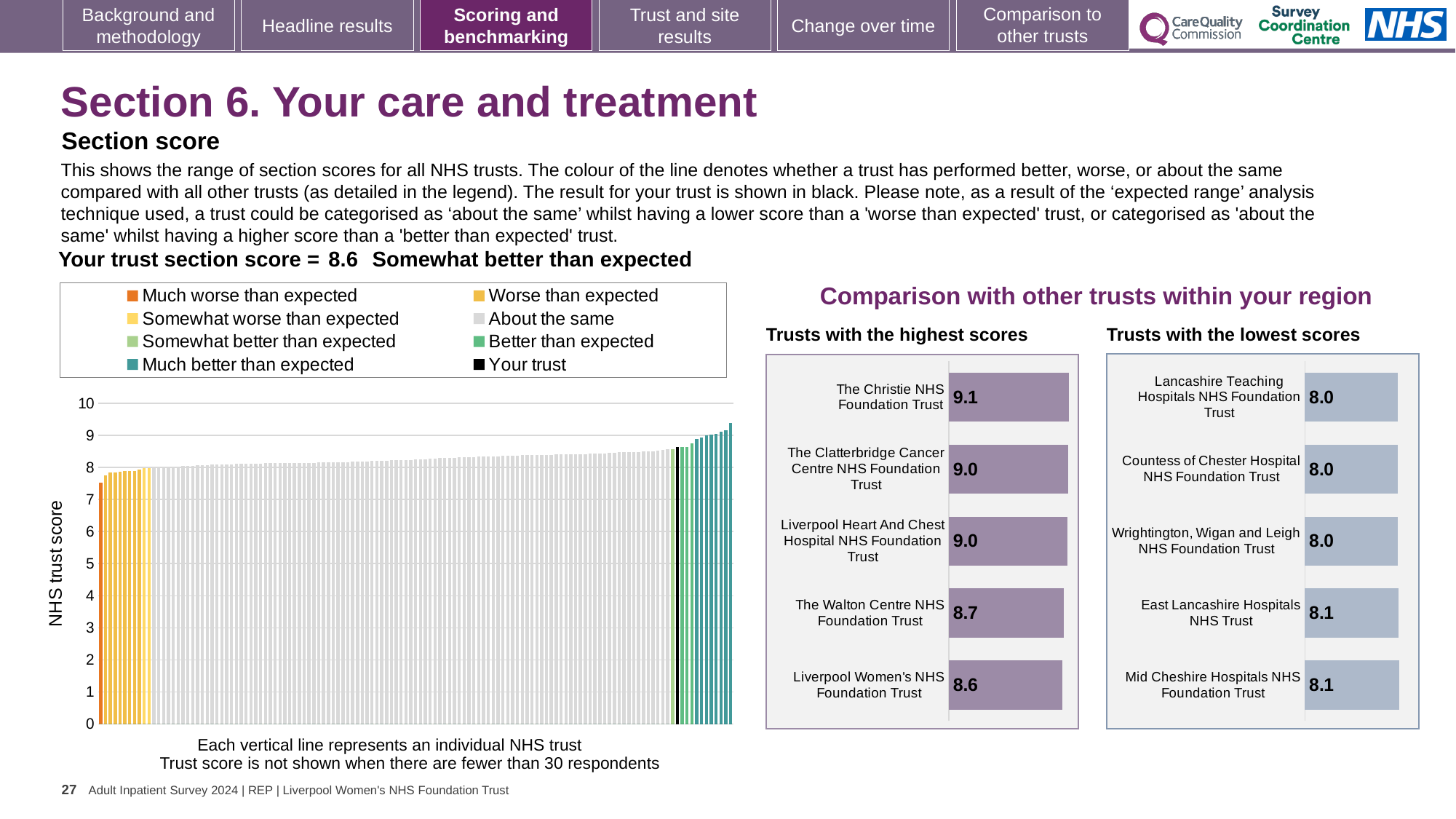
In the 'Trusts with the lowest scores' chart, what is the score for Wrightington, Wigan and Leigh NHS Foundation Trust? 8.0 In the 'Trusts with the highest scores' chart, which has the larger score: The Christie NHS Foundation Trust or The Walton Centre NHS Foundation Trust? The Christie NHS Foundation Trust In the main NHS trust score chart on the left, is the value of the lowest (leftmost) bar greater or less than 8? less How many trusts are shown in the 'Trusts with the lowest scores' chart? 5 In the 'Trusts with the highest scores' chart, what is the difference between the scores of The Christie NHS Foundation Trust and Liverpool Women's NHS Foundation Trust? 0.5 In the 'Trusts with the highest scores' chart, which trust has the lowest score? Liverpool Women's NHS Foundation Trust In the 'Trusts with the lowest scores' chart, what is the score for East Lancashire Hospitals NHS Trust? 8.1 In the main NHS trust score chart on the left, do the values rise or fall from left to right? rise In the 'Trusts with the highest scores' chart, which trust has the highest score? The Christie NHS Foundation Trust How many entries does the legend of the main NHS trust score chart list? 8 In the 'Trusts with the highest scores' chart, what is the score for Liverpool Women's NHS Foundation Trust? 8.6 In the 'Trusts with the highest scores' chart, what is the score for The Christie NHS Foundation Trust? 9.1